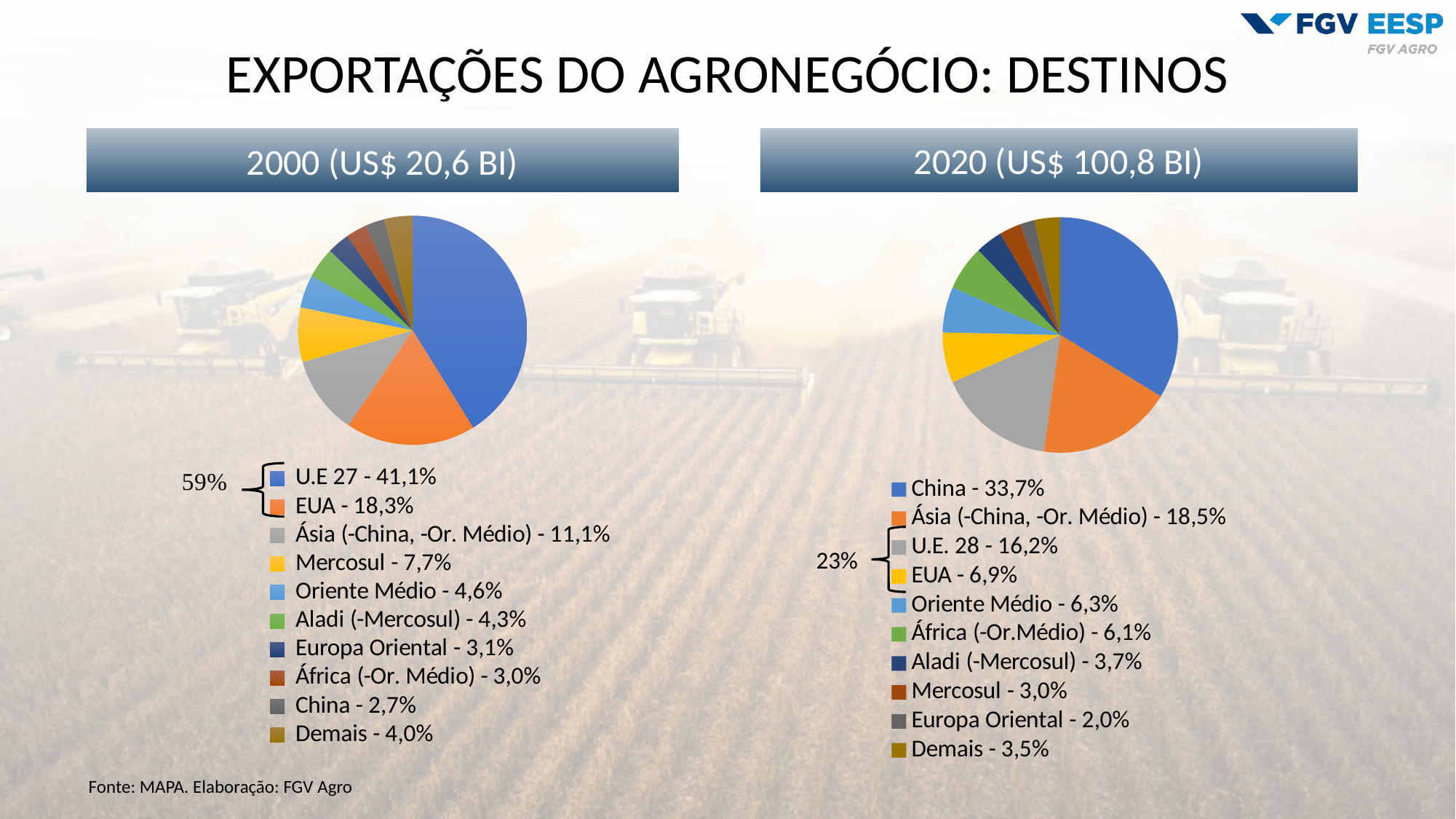
In the 2000 (US$ 20,6 BI) chart, what share does Mercosul have? 7,7% In the 2020 (US$ 100,8 BI) chart, which destination has the smallest share? Europa Oriental In the 2000 (US$ 20,6 BI) chart, what is the difference between the shares of U.E 27 and EUA? 22,8% In the 2020 (US$ 100,8 BI) chart, which is larger: the share of Oriente Médio or the share of África (-Or.Médio)? Oriente Médio In the 2000 (US$ 20,6 BI) chart, which destination has the smallest share? China In the 2020 (US$ 100,8 BI) chart, what is the combined share of U.E. 28 and EUA as annotated on the slide? 23% How many destination categories does the legend of the 2020 (US$ 100,8 BI) chart list? 10 In the 2020 (US$ 100,8 BI) chart, which destination has the largest share? China In the 2000 (US$ 20,6 BI) chart, what share does U.E 27 have? 41,1% What kind of chart is used for the 2000 (US$ 20,6 BI) data? pie chart How many destination categories does the legend of the 2000 (US$ 20,6 BI) chart list? 10 In the 2020 (US$ 100,8 BI) chart, what share does China have? 33,7%